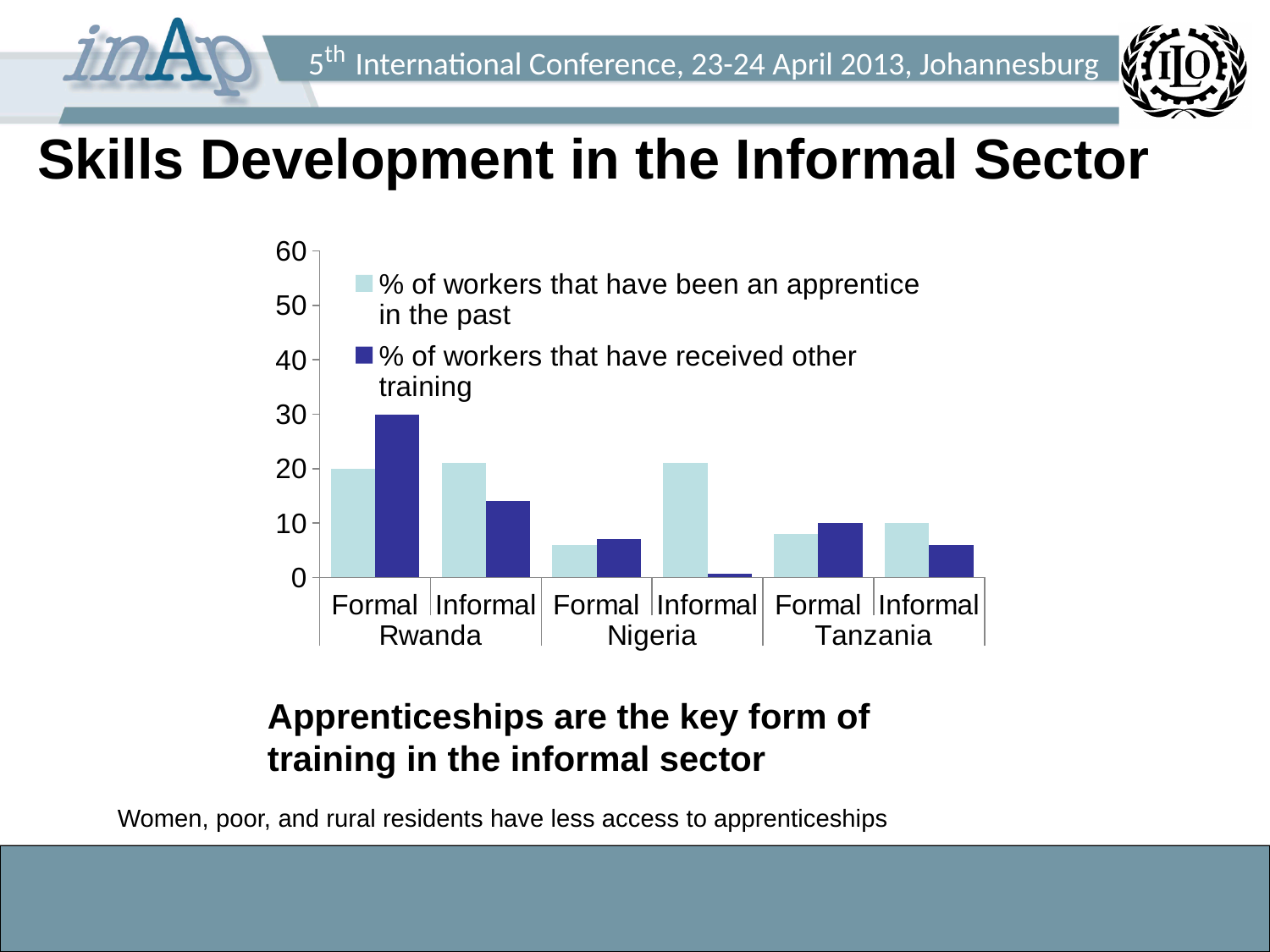
How many series does the chart's legend list? 2 Which bar is the highest in the whole chart? Formal Rwanda, % of workers that have received other training For Informal in Nigeria, which is larger: the share of workers that have been an apprentice in the past or the share that have received other training? % of workers that have been an apprentice in the past What kind of chart is shown on the slide? bar chart Is the value for '% of workers that have been an apprentice in the past' for Informal in Nigeria greater or less than 10? greater Is the value for '% of workers that have received other training' for Informal in Rwanda greater or less than 20? less For Formal in Rwanda, which is larger: the share of workers that have been an apprentice in the past or the share that have received other training? % of workers that have received other training How many category groups (Formal/Informal bars) are shown along the x axis? 6 How many countries are shown along the x axis of the chart? 3 What is the value for '% of workers that have been an apprentice in the past' for Formal in Rwanda? 20 What is the value for '% of workers that have received other training' for Formal in Rwanda? 30 For which category is '% of workers that have received other training' lowest? Informal Nigeria